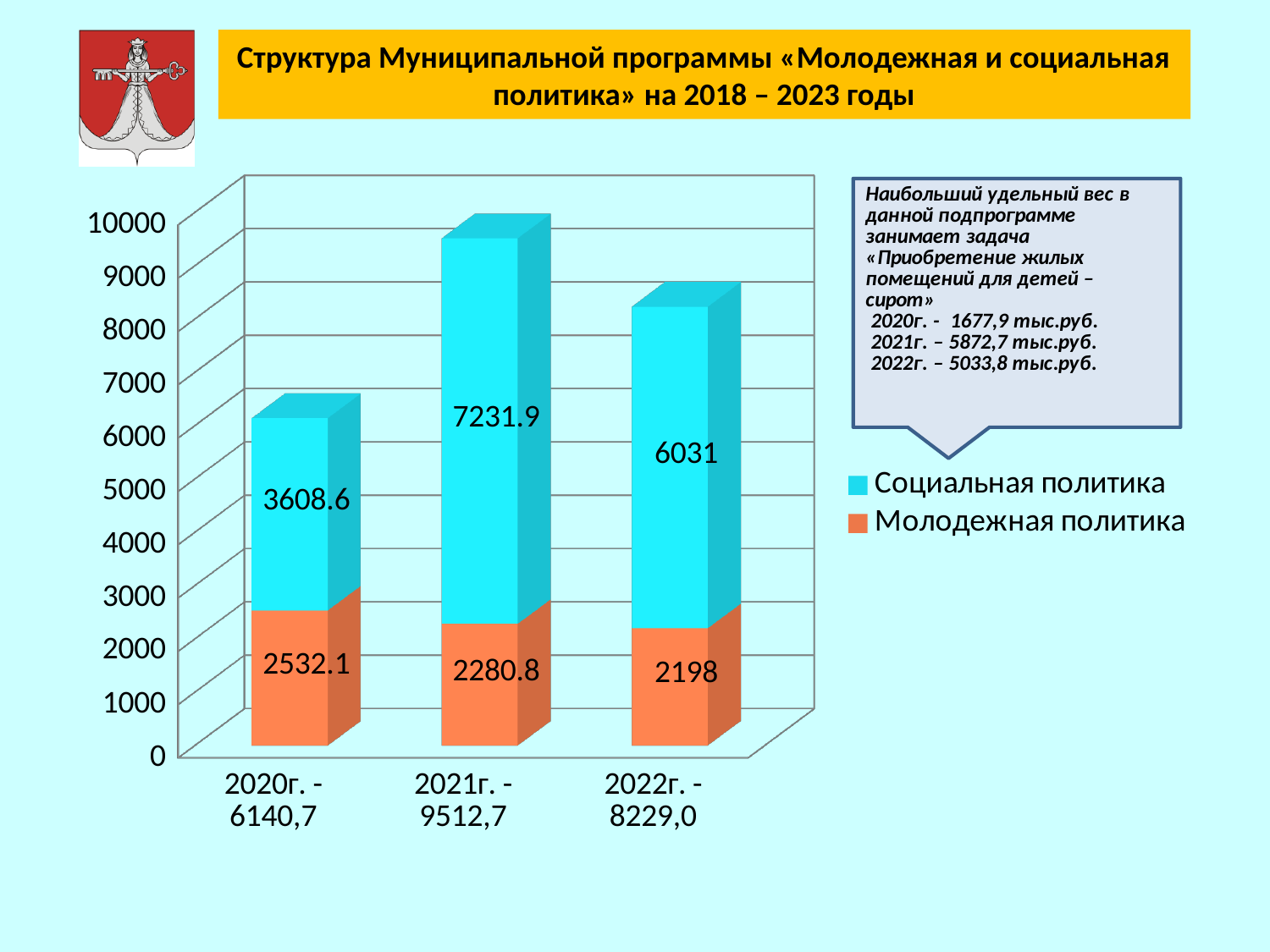
How many series does the legend list? 2 What is the total of the stacked bar for 2021г.? 9512.7 What is the difference between the Социальная политика values for 2021г. and 2020г.? 3623.3 In which year is the value for Социальная политика the highest? 2021г. Which is larger: Молодежная политика in 2020г. or in 2021г.? 2020г. What is the value for Социальная политика in 2021г.? 7231.9 What is the value for Социальная политика in 2022г.? 6031 In which year is the value for Молодежная политика the lowest? 2022г. What kind of chart is shown on the slide? Stacked bar chart What is the value for Молодежная политика in 2022г.? 2198 Which colour represents Молодежная политика in the legend? Orange What is the value for Молодежная политика in 2020г.? 2532.1